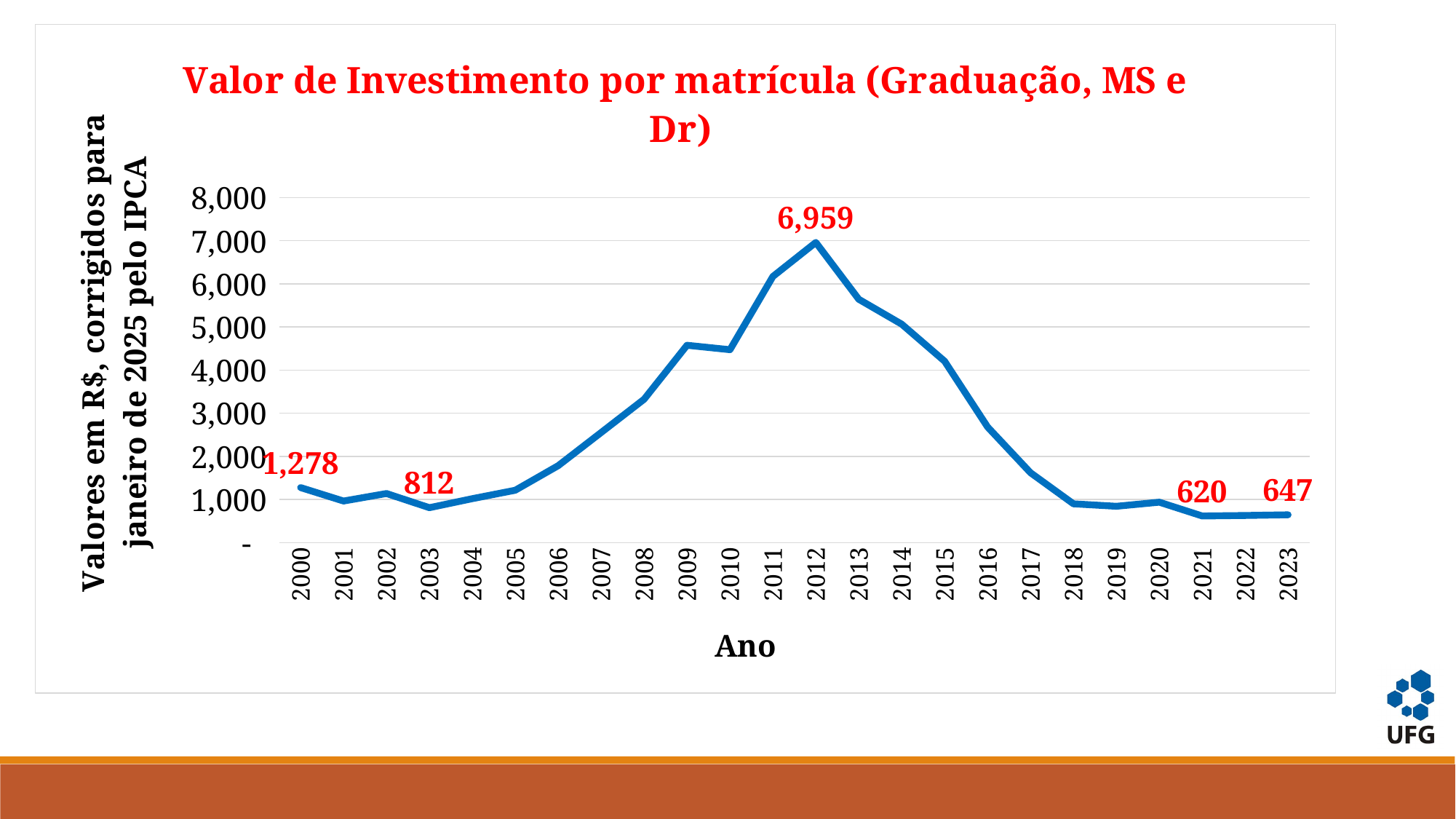
What type of chart is shown on the slide? line chart Is the value for 2009 greater or less than 4,000? greater What is the value for 2000? 1,278 What is the value for 2021? 620 Which year has the highest value? 2012 What is the difference between the values for 2023 and 2021? 27 What is the value for 2012? 6,959 Which is larger, the value for 2003 or the value for 2023? 2003 How many years are plotted on the x axis? 24 Do the values rise or fall from 2012 to 2018? fall Is the value for 2017 greater or less than 2,000? less What is the difference between the values for 2012 and 2000? 5,681